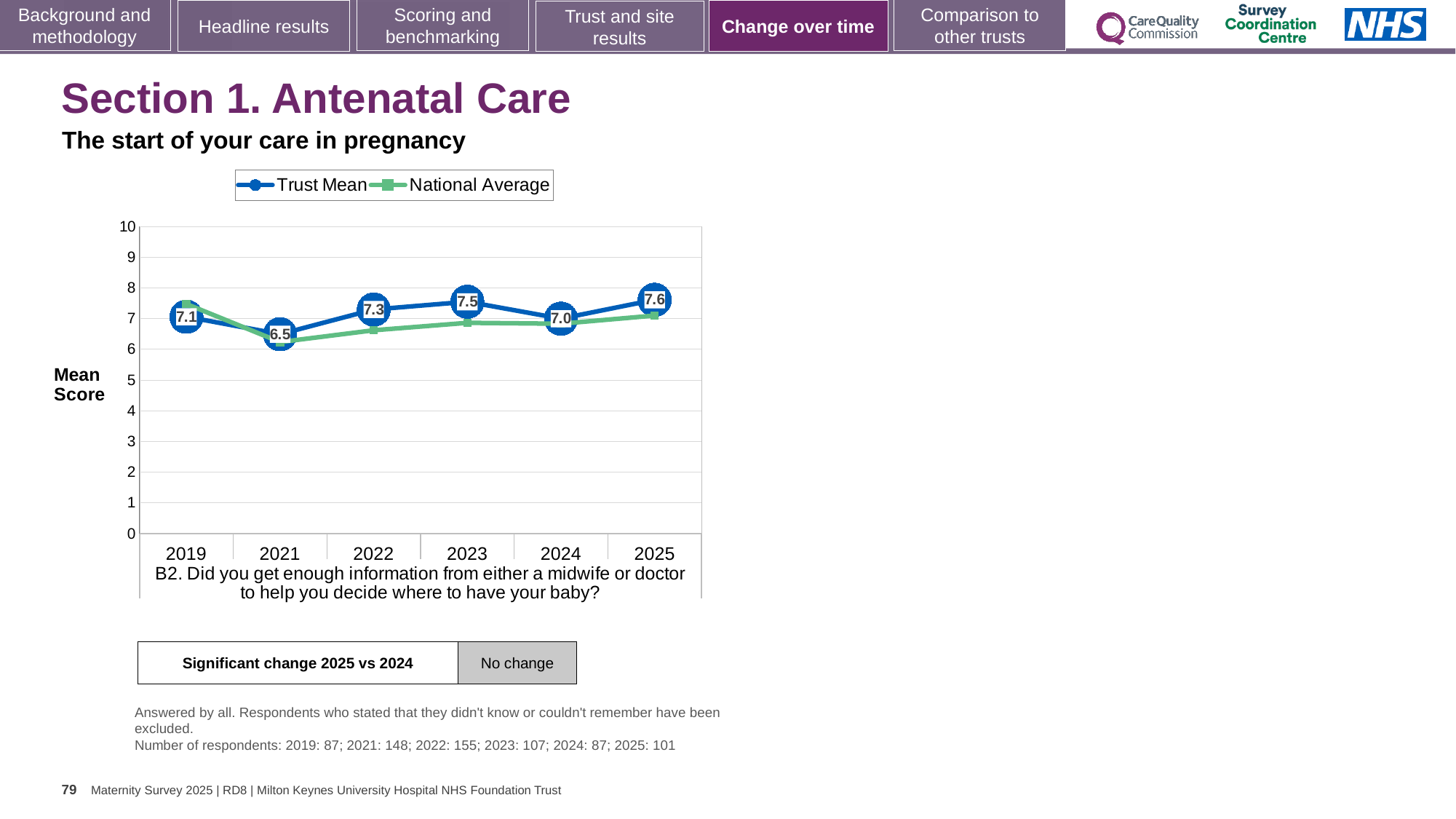
Did the Trust Mean score rise or fall from 2024 to 2025? Rise What is the Trust Mean score for 2025? 7.6 What is the Trust Mean score for 2023? 7.5 What is the difference between the Trust Mean scores for 2025 and 2024? 0.6 How many years are plotted on the x axis? 6 How many series does the legend list? 2 What type of chart is shown on the slide? Line chart Which year has the larger Trust Mean score, 2022 or 2024? 2022 In which year is the Trust Mean score lowest? 2021 What is the Trust Mean score for 2021? 6.5 In which year is the Trust Mean score highest? 2025 Is the National Average value for 2021 greater or less than 7? less